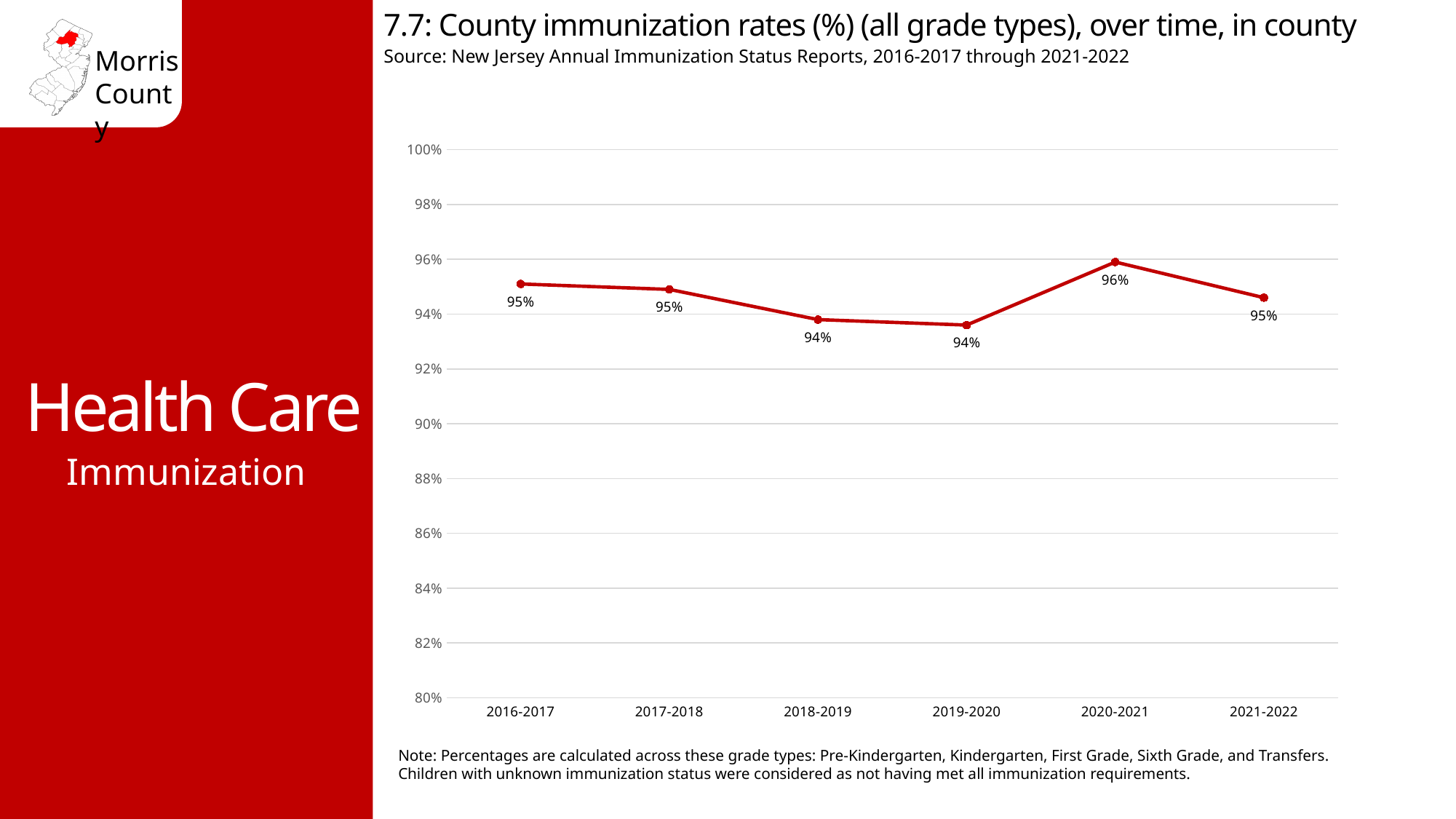
Is the value for 2019-2020 greater or less than 96%? less What was the county immunization rate in 2016-2017? 95% What was the county immunization rate in 2018-2019? 94% What is the difference between the immunization rate in 2020-2021 and in 2019-2020? 2% How many school years are plotted on the chart? 6 What type of chart is shown on the slide? Line chart What was the county immunization rate in 2020-2021? 96% What is the source cited for the chart data? New Jersey Annual Immunization Status Reports, 2016-2017 through 2021-2022 What was the county immunization rate in 2021-2022? 95% Which school year had the highest immunization rate? 2020-2021 Did the immunization rate rise or fall from 2016-2017 to 2019-2020? Fall Which year had a higher immunization rate, 2016-2017 or 2018-2019? 2016-2017